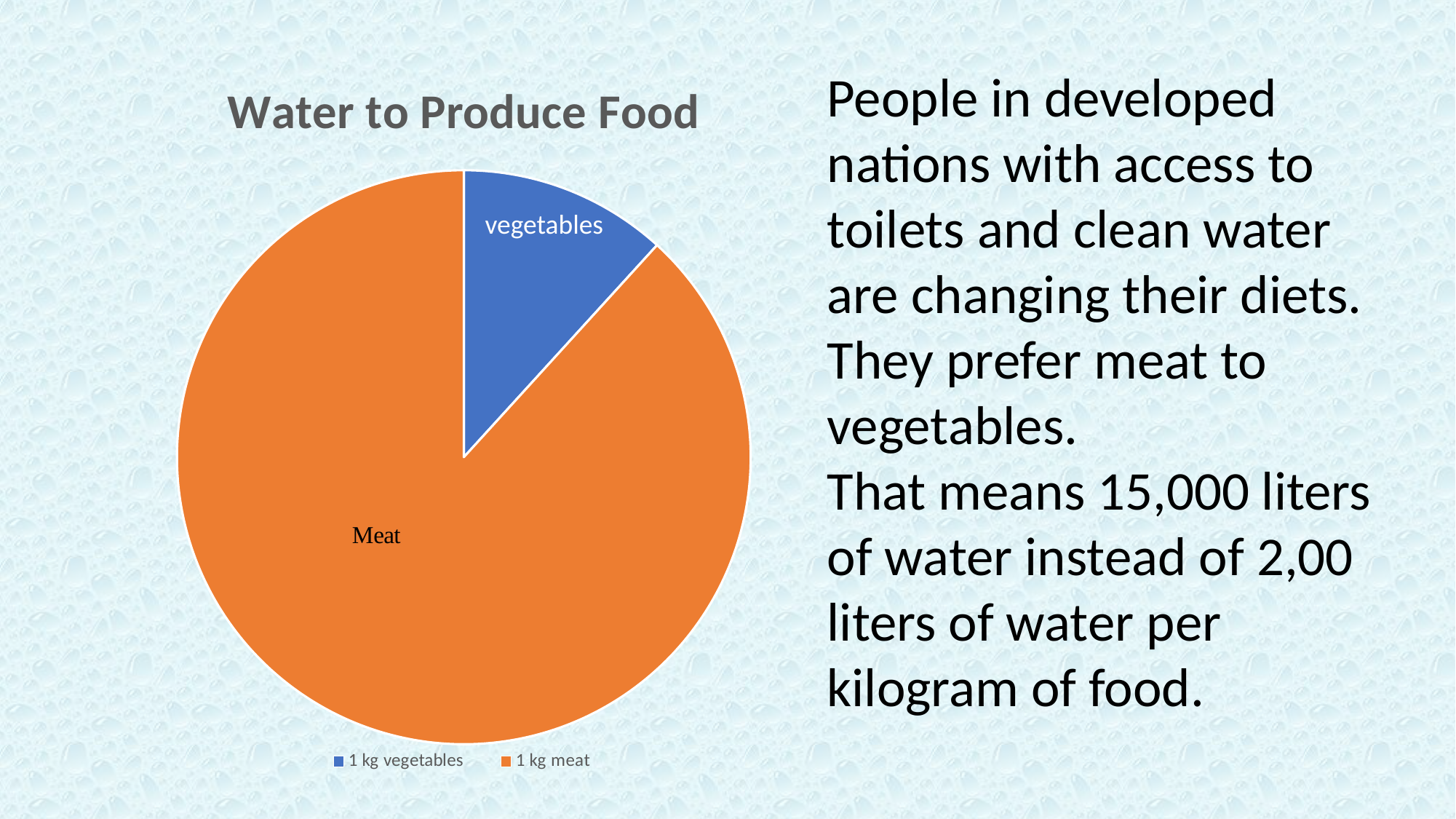
Which category takes up the largest share of the pie chart? Meat How many entries does the chart legend list? 2 Is the Meat slice more or less than half of the pie? more What kind of chart is shown on the slide? pie chart Which slice is larger, Meat or vegetables? Meat What colour is the Meat slice in the pie chart? orange Which category takes up the smallest share of the pie chart? vegetables What is the title of the chart? Water to Produce Food How many slices does the pie chart have? 2